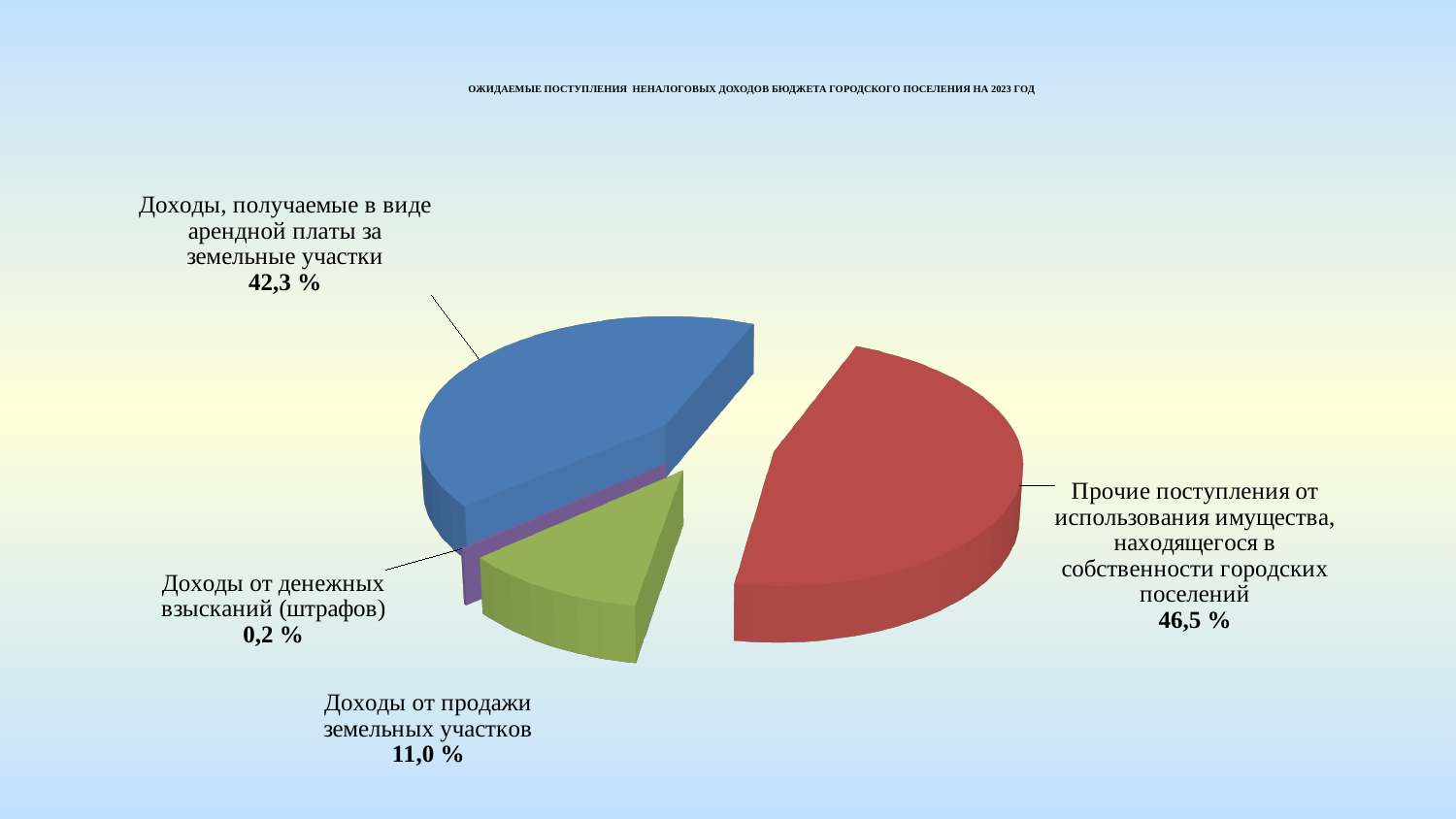
Which category has the largest share of the pie? Прочие поступления от использования имущества, находящегося в собственности городских поселений How many slices does the pie chart have? 4 Which category has the smallest share of the pie? Доходы от денежных взысканий (штрафов) What kind of chart is shown on the slide? Pie chart What is the difference in percentage points between "Доходы от продажи земельных участков" (11,0 %) and "Доходы от денежных взысканий (штрафов)" (0,2 %)? 10,8 What is the difference in percentage points between "Прочие поступления от использования имущества" (46,5 %) and "Доходы, получаемые в виде арендной платы за земельные участки" (42,3 %)? 4,2 What share is shown for "Доходы от денежных взысканий (штрафов)"? 0,2 % Which is larger: the share for "Доходы от продажи земельных участков" or the share for "Доходы от денежных взысканий (штрафов)"? Доходы от продажи земельных участков What share is shown for "Прочие поступления от использования имущества, находящегося в собственности городских поселений"? 46,5 % What share is shown for "Доходы от продажи земельных участков"? 11,0 % What colour is the slice for "Прочие поступления от использования имущества, находящегося в собственности городских поселений"? Red What share is shown for "Доходы, получаемые в виде арендной платы за земельные участки"? 42,3 %